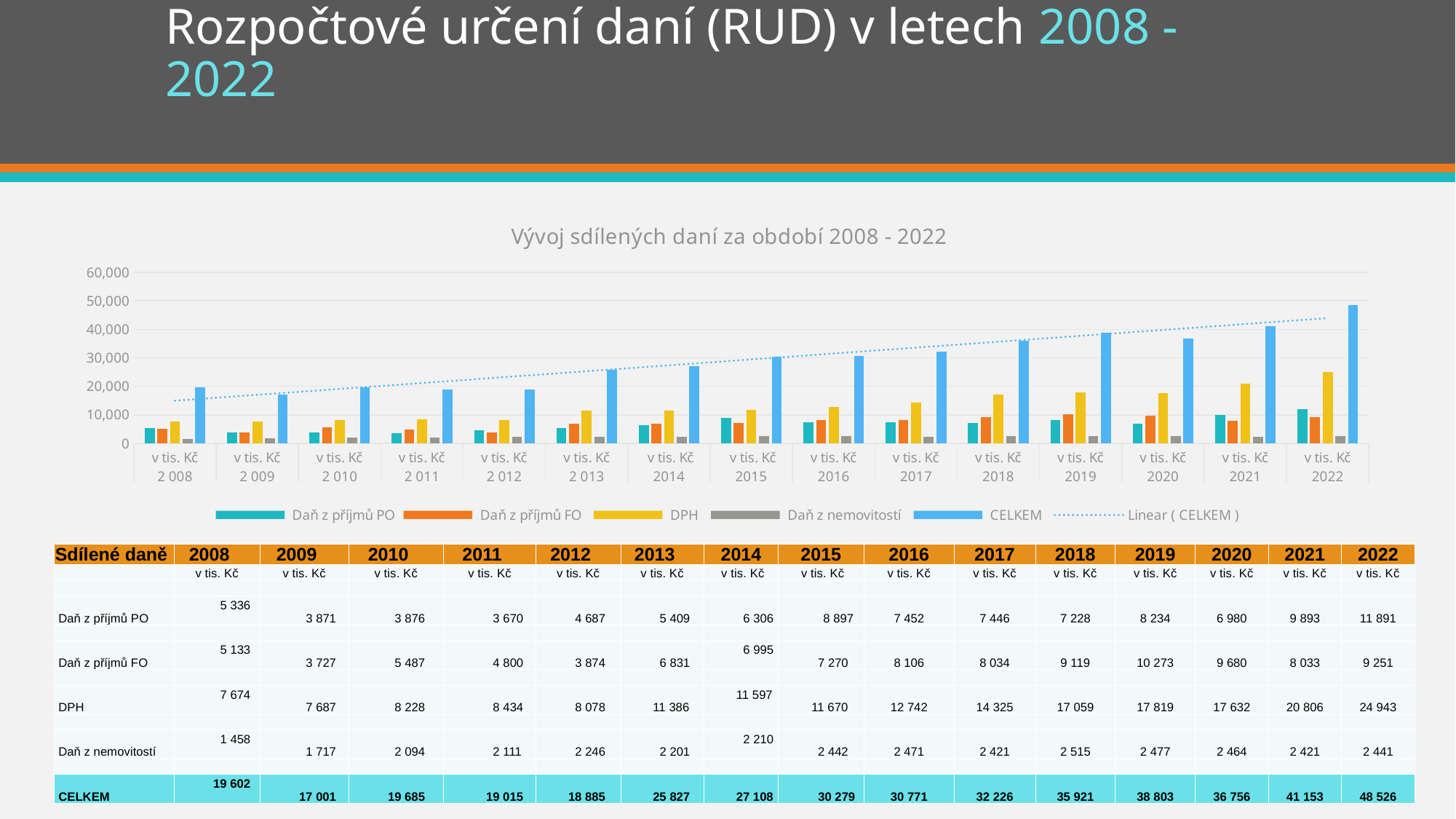
How many bar series does the chart's legend list (excluding the trendline)? 5 In which year is the CELKEM value lowest? 2009 In which year is the CELKEM value highest? 2022 Does the CELKEM series generally rise or fall from 2008 to 2022? rise What is the difference between the CELKEM values for 2022 and 2021? 7 373 Is the CELKEM value for 2013 greater or less than 20,000? greater What is the DPH value for 2022 (v tis. Kč)? 24 943 What is the title of the chart? Vývoj sdílených daní za období 2008 - 2022 What kind of chart is shown on the slide? bar chart What is the CELKEM value for 2022 (v tis. Kč)? 48 526 How many years (categories) are plotted along the x axis of the chart? 15 Is the CELKEM value for 2022 greater or less than 40,000? greater